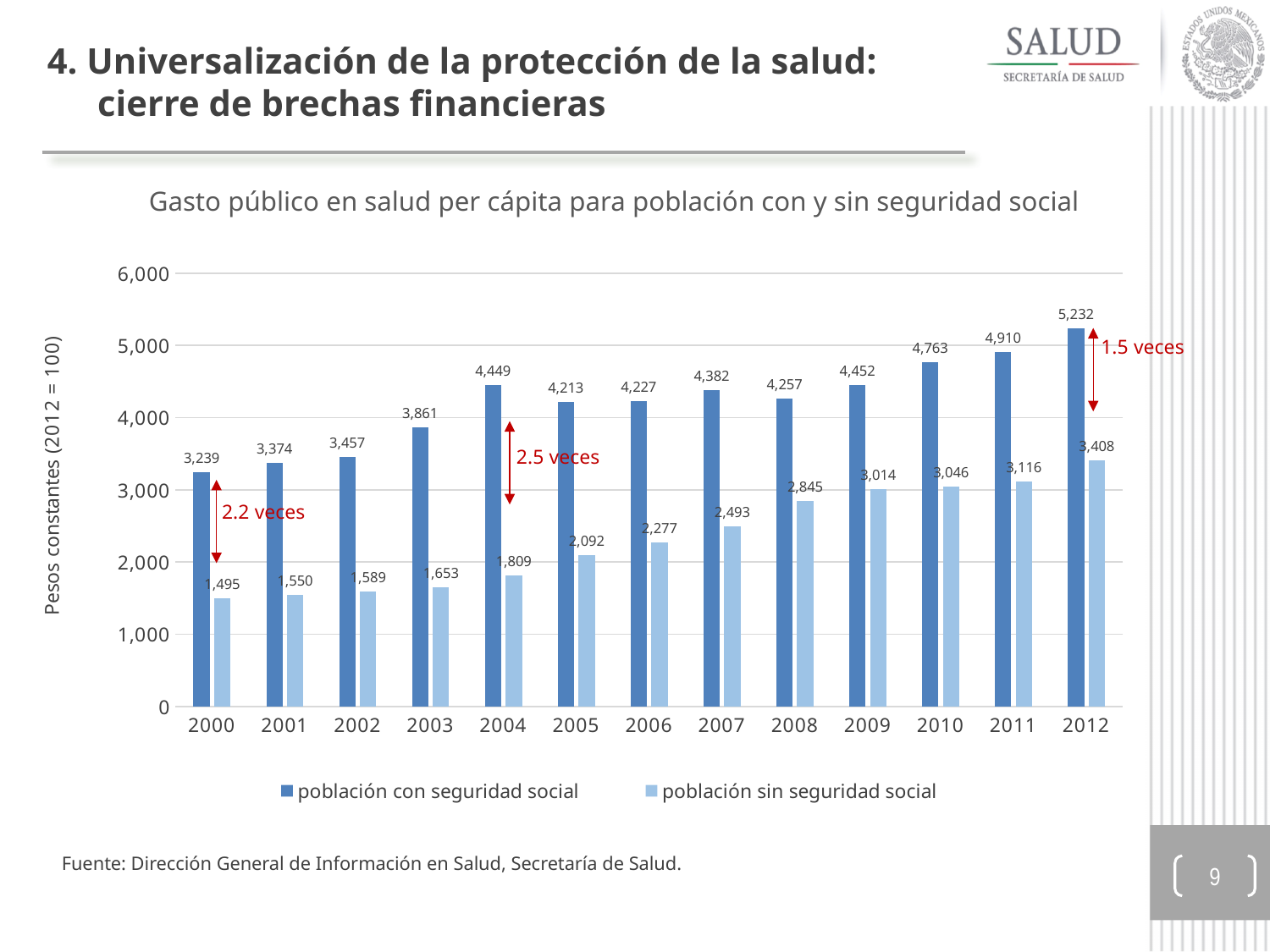
What kind of chart is shown on the slide? bar chart How many series does the legend list? 2 Does the value for población sin seguridad social rise or fall from 2000 to 2012? rise What is the difference between población con seguridad social and población sin seguridad social in 2012? 1,824 Which is larger, the value for población con seguridad social in 2005 or in 2007? 2007 In which year is the value for población sin seguridad social lowest? 2000 Is the value for población sin seguridad social in 2009 greater or less than 3,000? greater What is the value for población con seguridad social in 2004? 4,449 What is the title of the chart? Gasto público en salud per cápita para población con y sin seguridad social In which year is the value for población con seguridad social highest? 2012 What is the value for población sin seguridad social in 2008? 2,845 How many years are shown on the x axis? 13